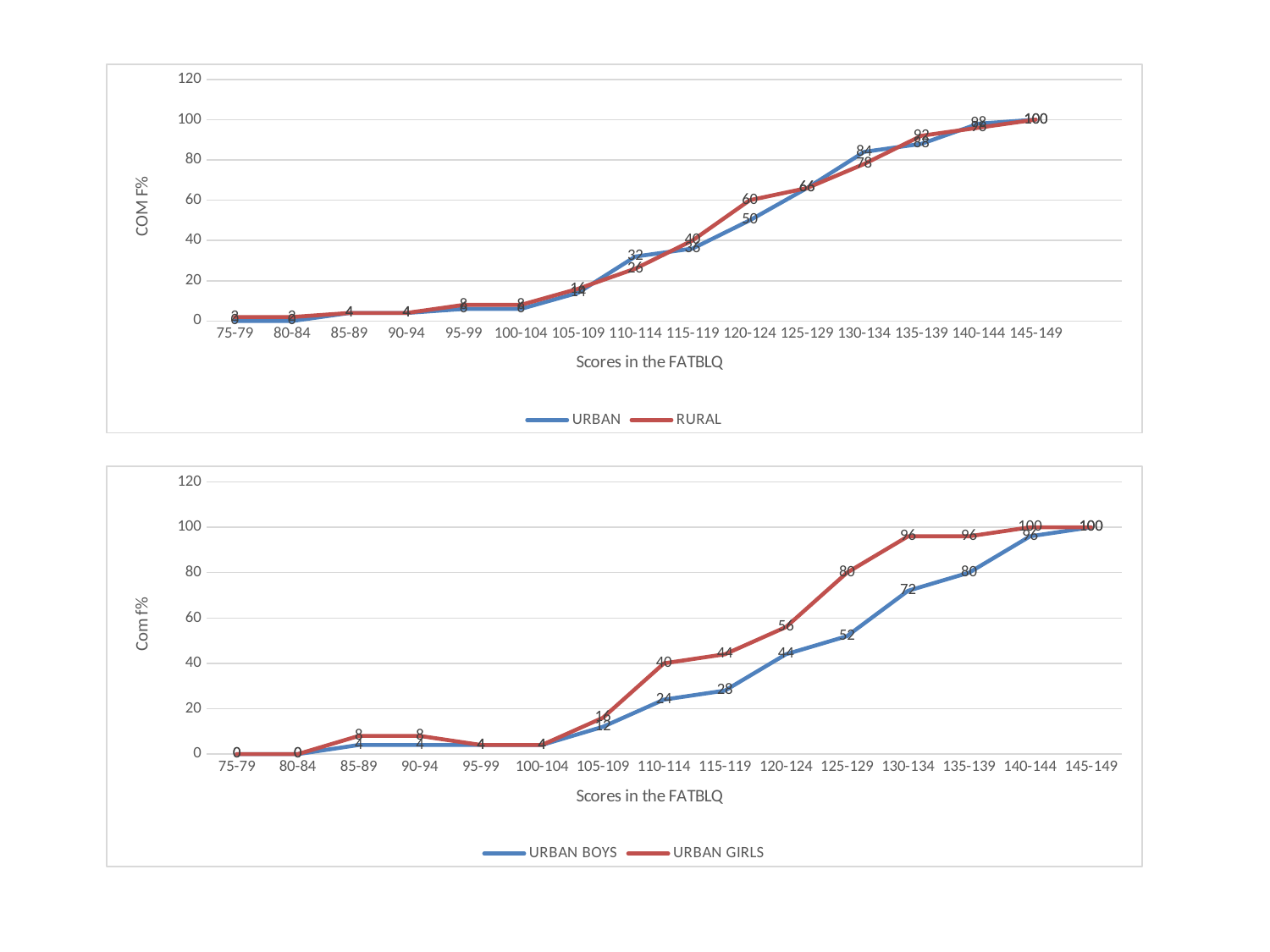
In the top chart (URBAN vs RURAL), which series has the larger value at 110-114? URBAN In the bottom chart (URBAN BOYS vs URBAN GIRLS), how many score categories are shown on the x axis? 15 In the bottom chart (URBAN BOYS vs URBAN GIRLS), which series has the larger value at 110-114? URBAN GIRLS In the top chart (URBAN vs RURAL), how many series does the legend list? 2 In the bottom chart (URBAN BOYS vs URBAN GIRLS), what is the URBAN BOYS value at 130-134? 72 In the bottom chart (URBAN BOYS vs URBAN GIRLS), what is the URBAN GIRLS value at 125-129? 80 In the top chart (URBAN vs RURAL), what is the difference between the RURAL and URBAN values at 130-134? 6 In the bottom chart (URBAN BOYS vs URBAN GIRLS), what is the difference between the URBAN GIRLS and URBAN BOYS values at 130-134? 24 What kind of chart is the bottom chart (URBAN BOYS vs URBAN GIRLS)? Line chart In the top chart (URBAN vs RURAL), what is the URBAN value at 120-124? 50 In the bottom chart (URBAN BOYS vs URBAN GIRLS), do the URBAN BOYS values generally rise or fall from 100-104 to 145-149? Rise In the top chart (URBAN vs RURAL), what is the RURAL value at 120-124? 60